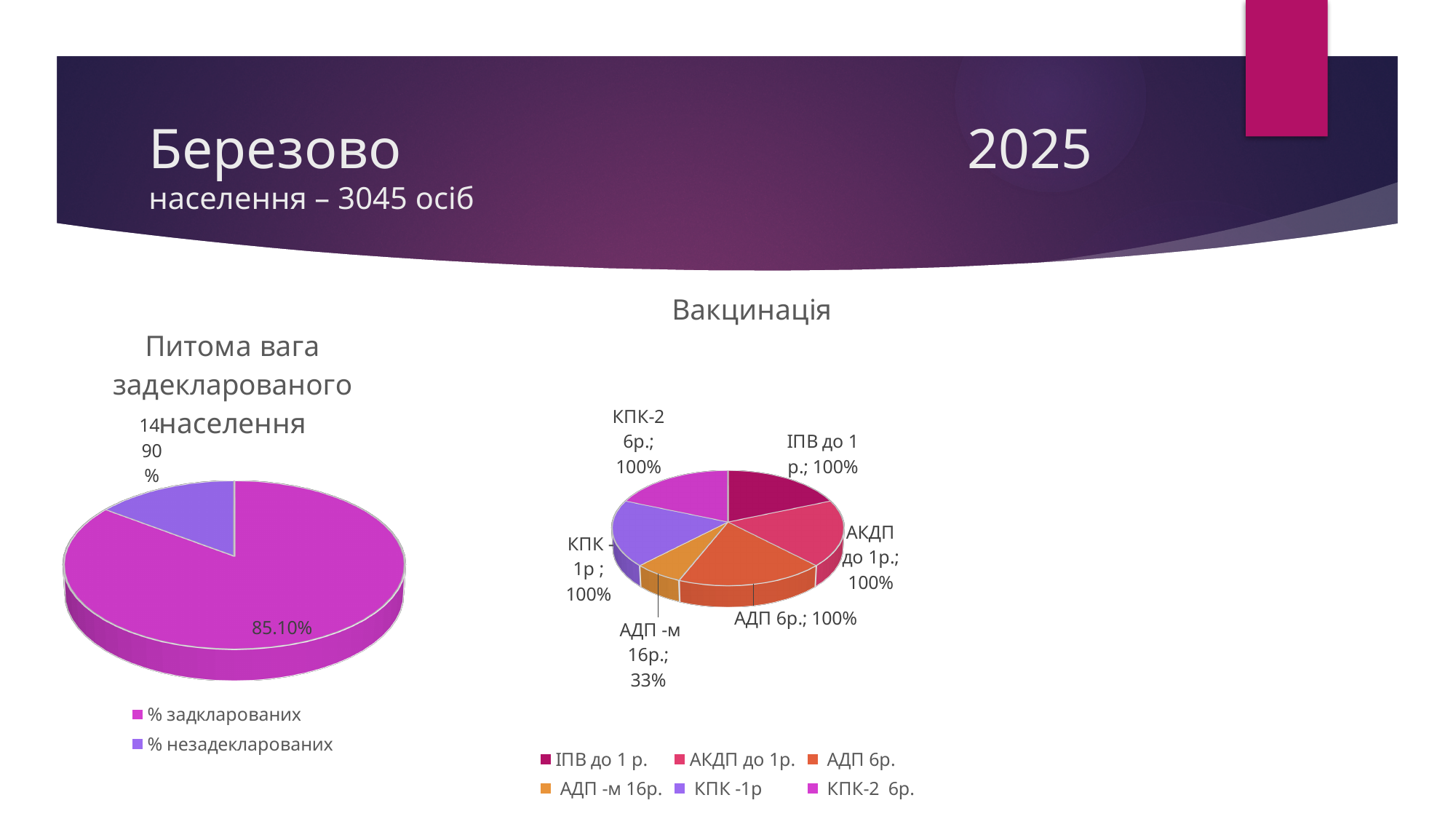
How many categories are shown in the chart titled "Вакцинація"? 6 In the chart titled "Питома вага задекларованого населення", what is the value for "% задклярованих"? 85.10% How many entries does the legend of the chart titled "Питома вага задекларованого населення" list? 2 In the chart titled "Вакцинація", what is the value for "КПК-2 6р."? 100% In the chart titled "Питома вага задекларованого населення", which slice is larger: "% задклярованих" or "% незадекларованих"? % задклярованих In the chart titled "Вакцинація", which category has the lowest value? АДП -м 16р. In the chart titled "Вакцинація", what is the value for "ІПВ до 1 р."? 100% In the chart titled "Вакцинація", what is the value for "АДП -м 16р."? 33% In the chart titled "Вакцинація", which is larger: the value for "АКДП до 1р." or the value for "АДП -м 16р."? АКДП до 1р. What kind of chart is the chart titled "Вакцинація"? pie chart In the chart titled "Вакцинація", what is the difference between the value for "АДП 6р." and the value for "АДП -м 16р."? 67% What kind of chart is the chart titled "Питома вага задекларованого населення"? pie chart